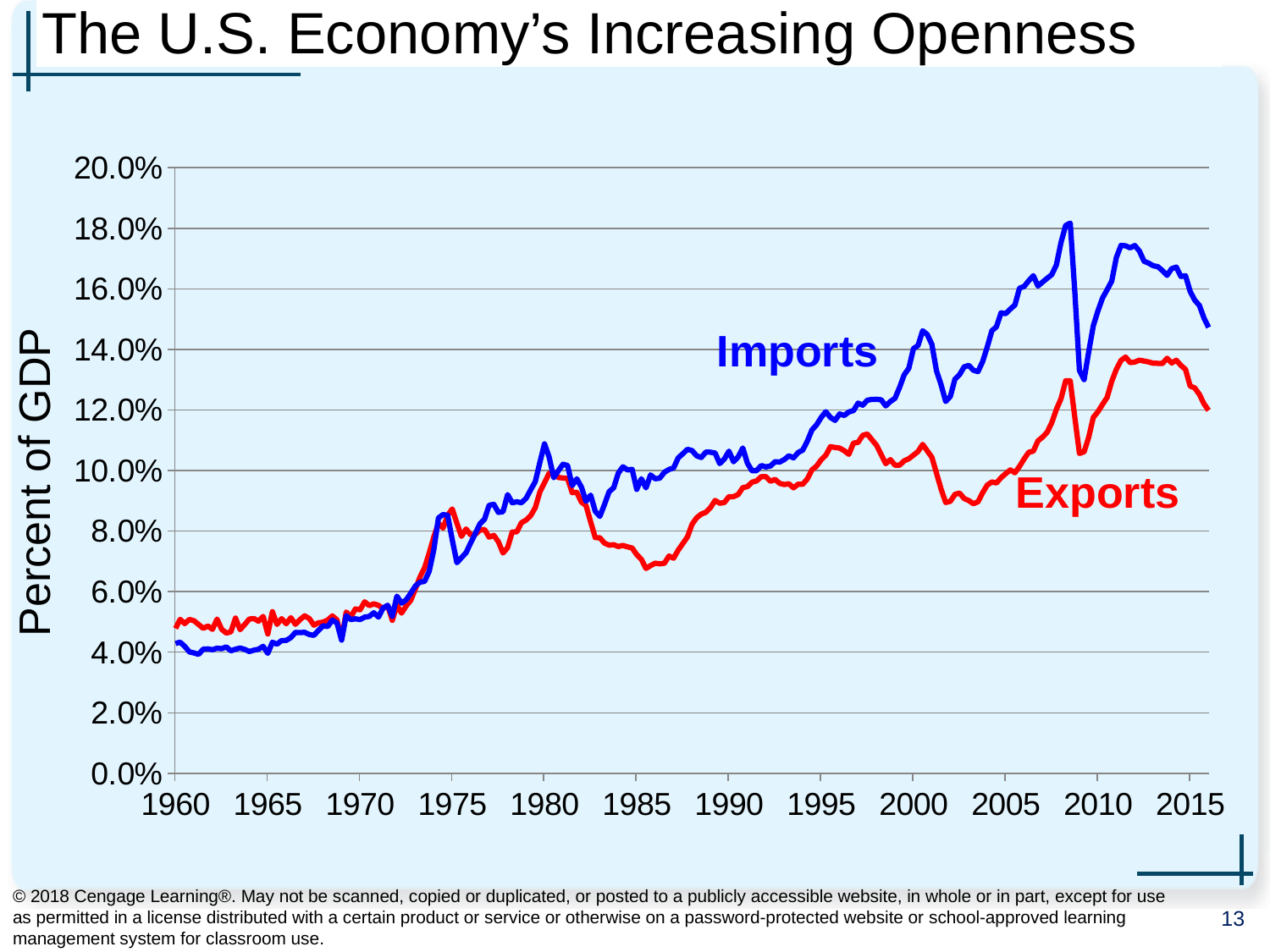
In 1960, which series has the larger value, Imports or Exports? Exports What are the names of the two series plotted on the chart? Imports and Exports Is the value for Exports in 1985 greater or less than 8.0%? less Which series reaches the higher peak value over the period shown, Imports or Exports? Imports What is the label on the vertical axis of the chart? Percent of GDP In 2015, which series has the larger value, Imports or Exports? Imports Is the value for Exports in 2012 greater or less than 12.0%? greater Is the value for Imports in 1960 greater or less than 6.0%? less What kind of chart is shown on the slide? line chart How many series are plotted on the chart? 2 Do the Imports values generally rise or fall from 1960 to 2015? rise